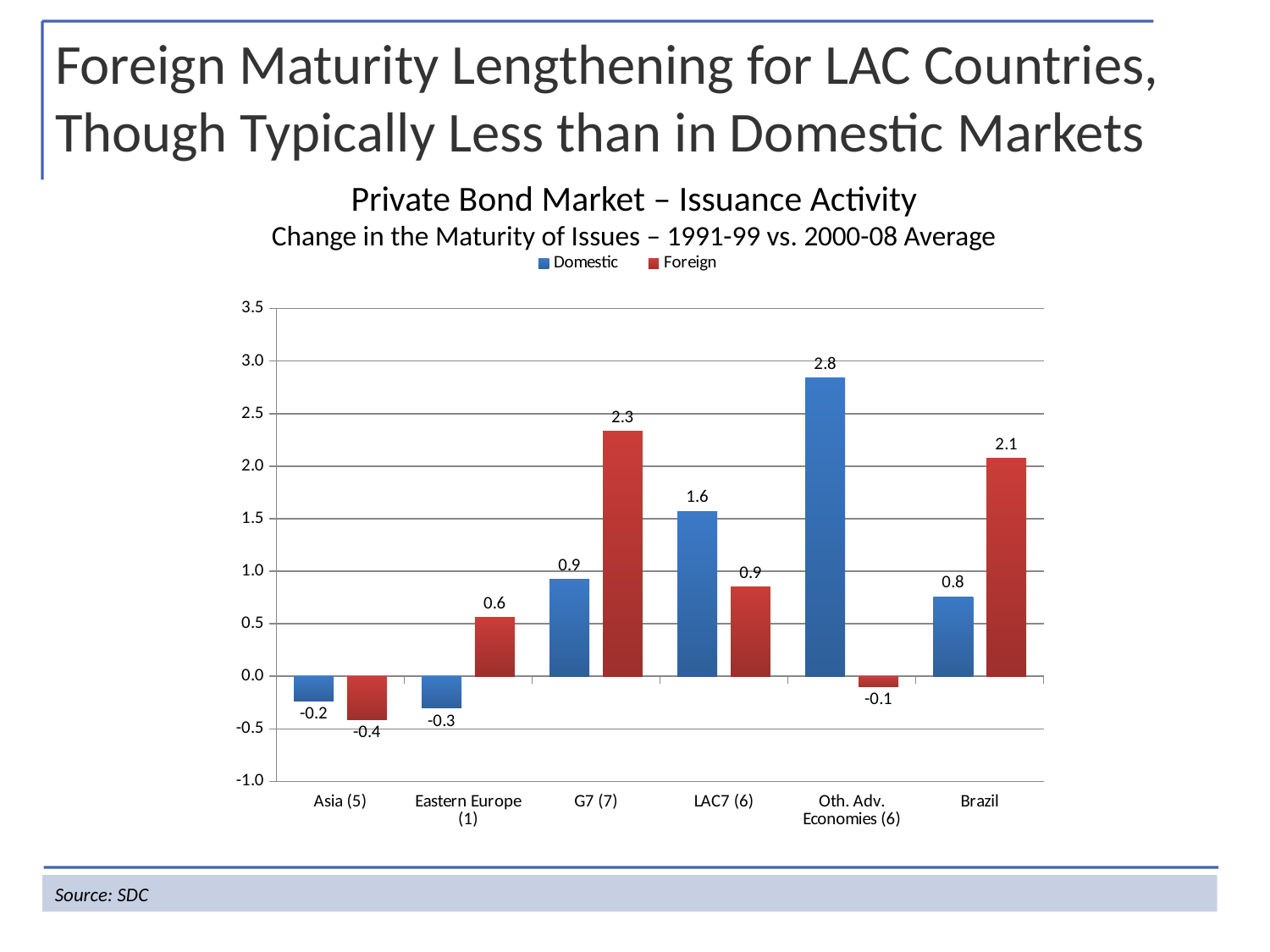
How many categories are shown on the x axis? 6 Which category has the lowest Foreign value? Asia (5) How many series does the legend list? 2 What is the source cited for the chart? SDC What kind of chart is shown on the slide? bar chart What is the Domestic value for LAC7 (6)? 1.6 Is the Domestic value for Oth. Adv. Economies (6) greater or less than 2.5? greater Which category has the highest Domestic value? Oth. Adv. Economies (6) Which is larger for LAC7 (6), the Domestic value or the Foreign value? Domestic What is the Foreign value for Asia (5)? -0.4 What is the Foreign value for Brazil? 2.1 What is the difference between the Foreign and Domestic values for G7 (7)? 1.4